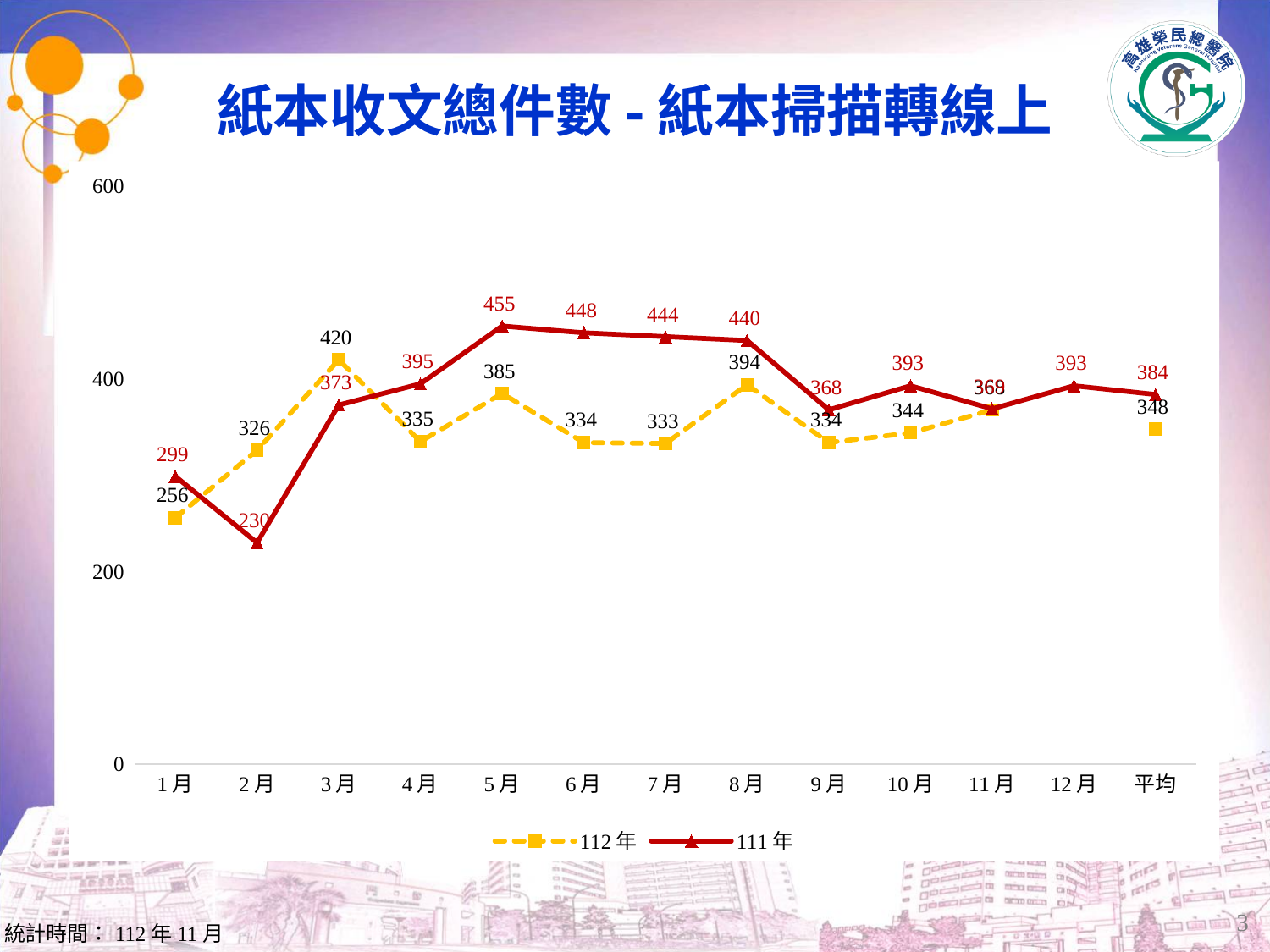
How many series does the legend list? 2 In which month is the 111年 series at its lowest? 2月 In 2月, which series has the higher value, 112年 or 111年? 112年 What is the 平均 value for the 111年 series? 384 In which month does the 111年 series reach its highest value? 5月 Does the 111年 series rise or fall from 5月 to 8月? Fall What is the difference between the 111年 and 112年 values in 5月? 70 What is the value for 112年 in 3月? 420 In which month does the 112年 series have its highest value? 3月 What is the value for 112年 in 8月? 394 What is the value for 111年 in 5月? 455 What kind of chart is shown on the slide? Line chart